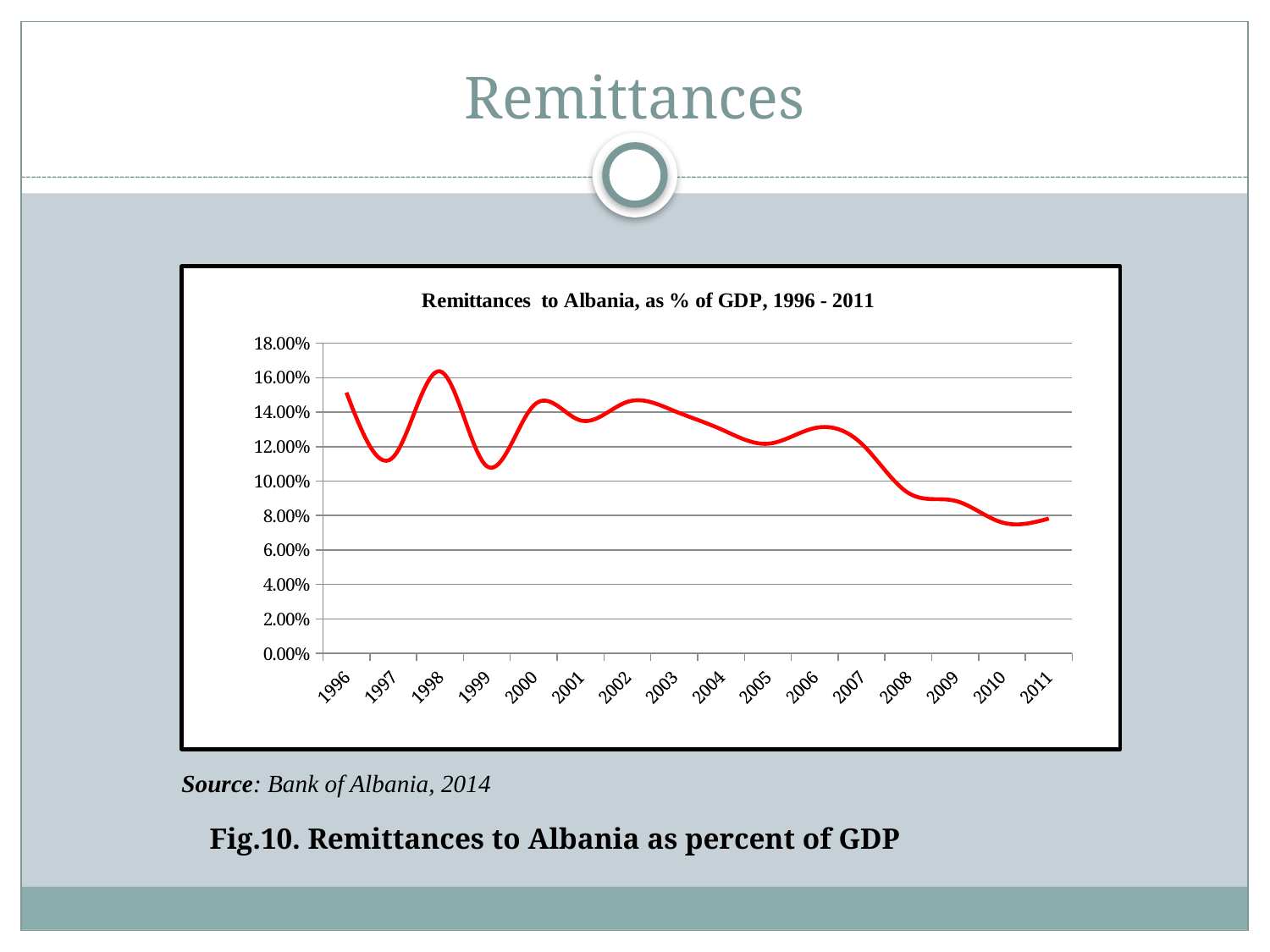
Is the value for 1997 greater or less than 12.00%? less Is the value for 1996 greater or less than 14.00%? greater In which year is remittances as % of GDP highest? 1998 Is the value for 2008 greater or less than 10.00%? less Overall, do remittances as % of GDP rise or fall from 1996 to 2011? fall What is the title of the chart? Remittances to Albania, as % of GDP, 1996 - 2011 What kind of chart is shown on the slide? line chart Which year has the larger value, 1998 or 1999? 1998 Which year has the larger value, 2002 or 2010? 2002 How many years are plotted along the x axis of the chart? 16